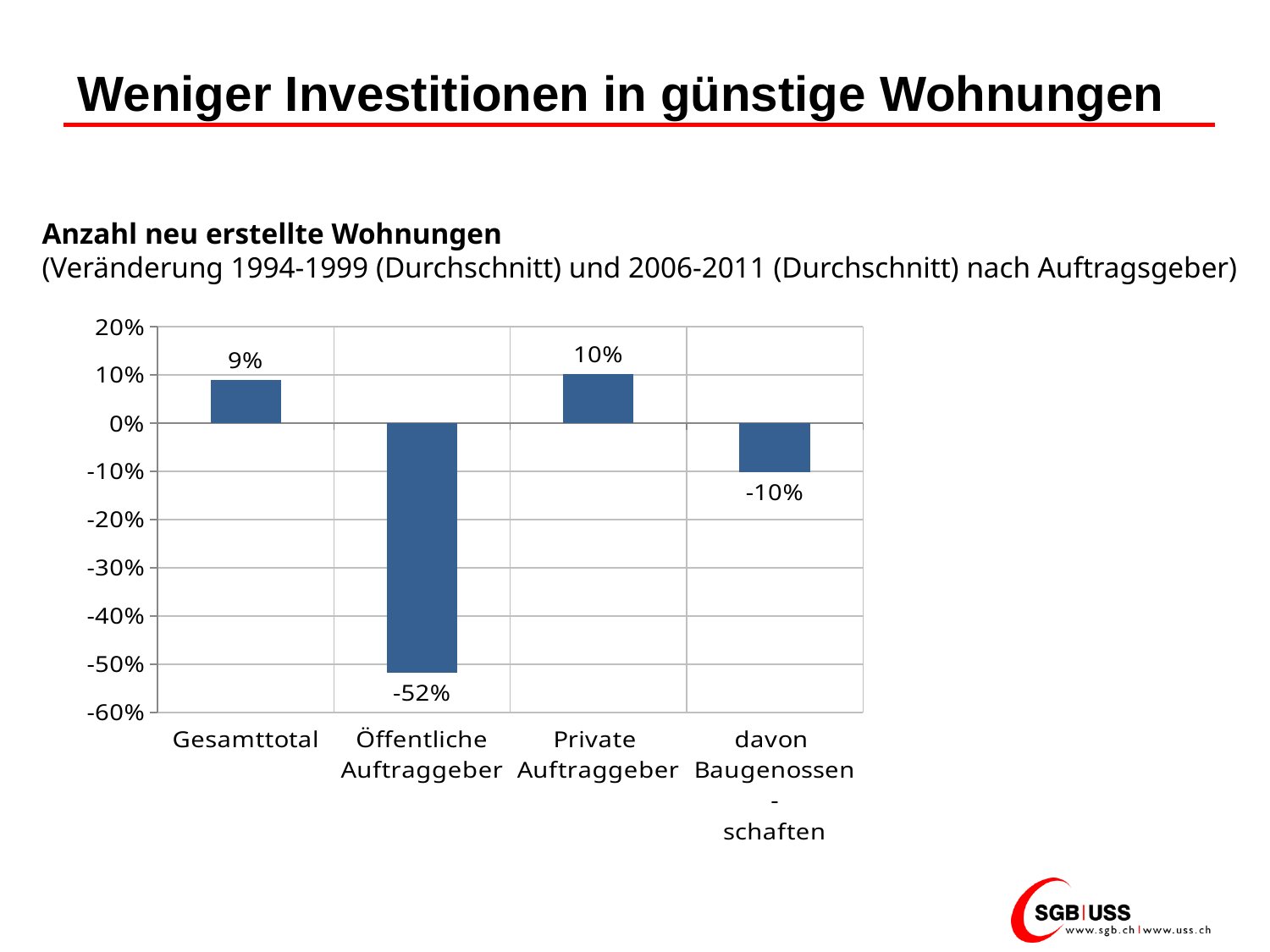
Which is larger, the value for Gesamttotal or the value for davon Baugenossenschaften? Gesamttotal Is the value for Öffentliche Auftraggeber greater or less than -40%? less What is the difference between the values for Private Auftraggeber and Gesamttotal? 1% What is the value for davon Baugenossenschaften? -10% Which category has the highest value? Private Auftraggeber Which category has the lowest value? Öffentliche Auftraggeber What is the difference between the values for davon Baugenossenschaften and Öffentliche Auftraggeber? 42% What is the value for Gesamttotal? 9% What is the value for Private Auftraggeber? 10% What kind of chart is shown on the slide? bar chart How many categories are shown on the x axis? 4 What is the value for Öffentliche Auftraggeber? -52%